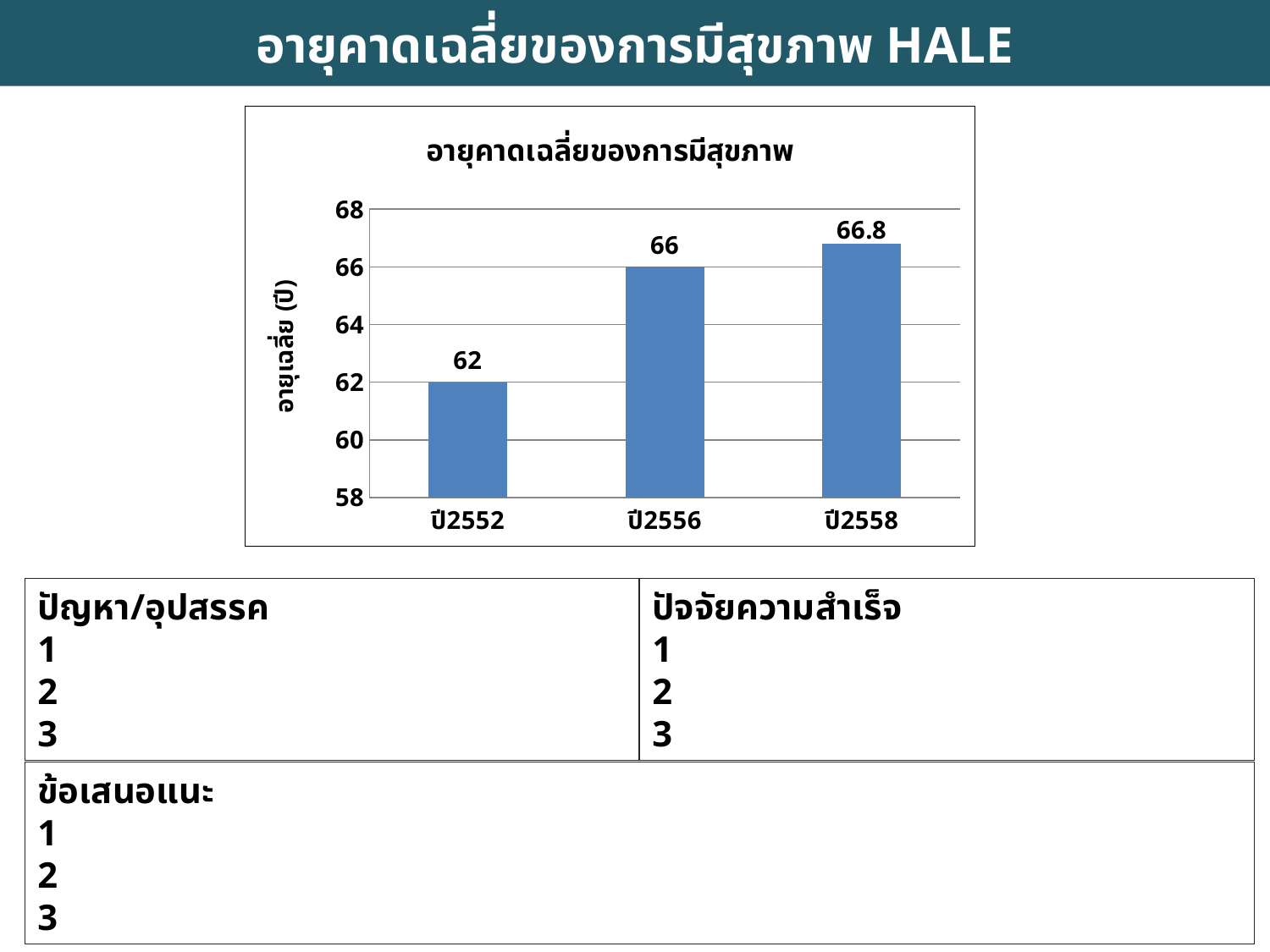
What kind of chart is this? bar chart Which category has the lowest value? ปี2552 What is the value for ปี2556? 66 Is the value for ปี2558 greater or less than 66? greater What is the difference between the values for ปี2556 and ปี2552? 4 What is the value for ปี2558? 66.8 Which is larger, the value for ปี2552 or the value for ปี2556? ปี2556 How many categories are shown on the x axis? 3 Which category has the highest value? ปี2558 Do the values rise or fall from ปี2552 to ปี2558? rise What is the value for ปี2552? 62 What is the difference between the values for ปี2558 and ปี2556? 0.8